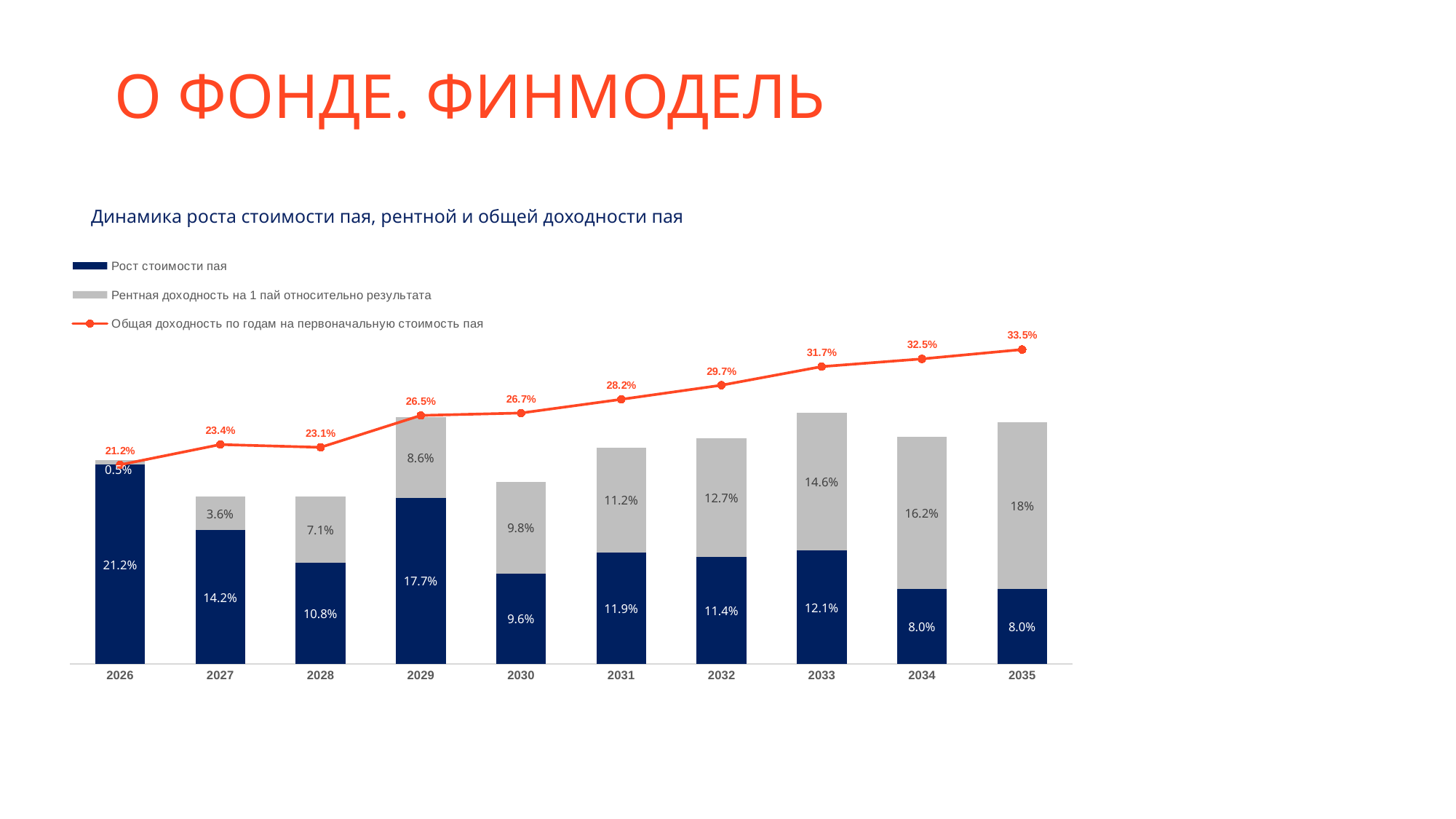
How many years are shown on the x axis? 10 Does Рентная доходность на 1 пай относительно результата rise or fall from 2026 to 2035? rise Which is larger in 2032: Рост стоимости пая or Рентная доходность на 1 пай относительно результата? Рентная доходность на 1 пай относительно результата What is the value of Рост стоимости пая for 2029? 17.7% In which year is Общая доходность по годам на первоначальную стоимость пая highest? 2035 What is the value of Общая доходность по годам на первоначальную стоимость пая for 2031? 28.2% What is the total of the stacked bar for 2035? 26% What is the difference between Общая доходность in 2035 and in 2026? 12.3% What is the value of Рентная доходность на 1 пай относительно результата for 2033? 14.6% In which year is Рентная доходность на 1 пай относительно результата lowest? 2026 In which year is Рост стоимости пая highest? 2026 How many series does the legend list? 3